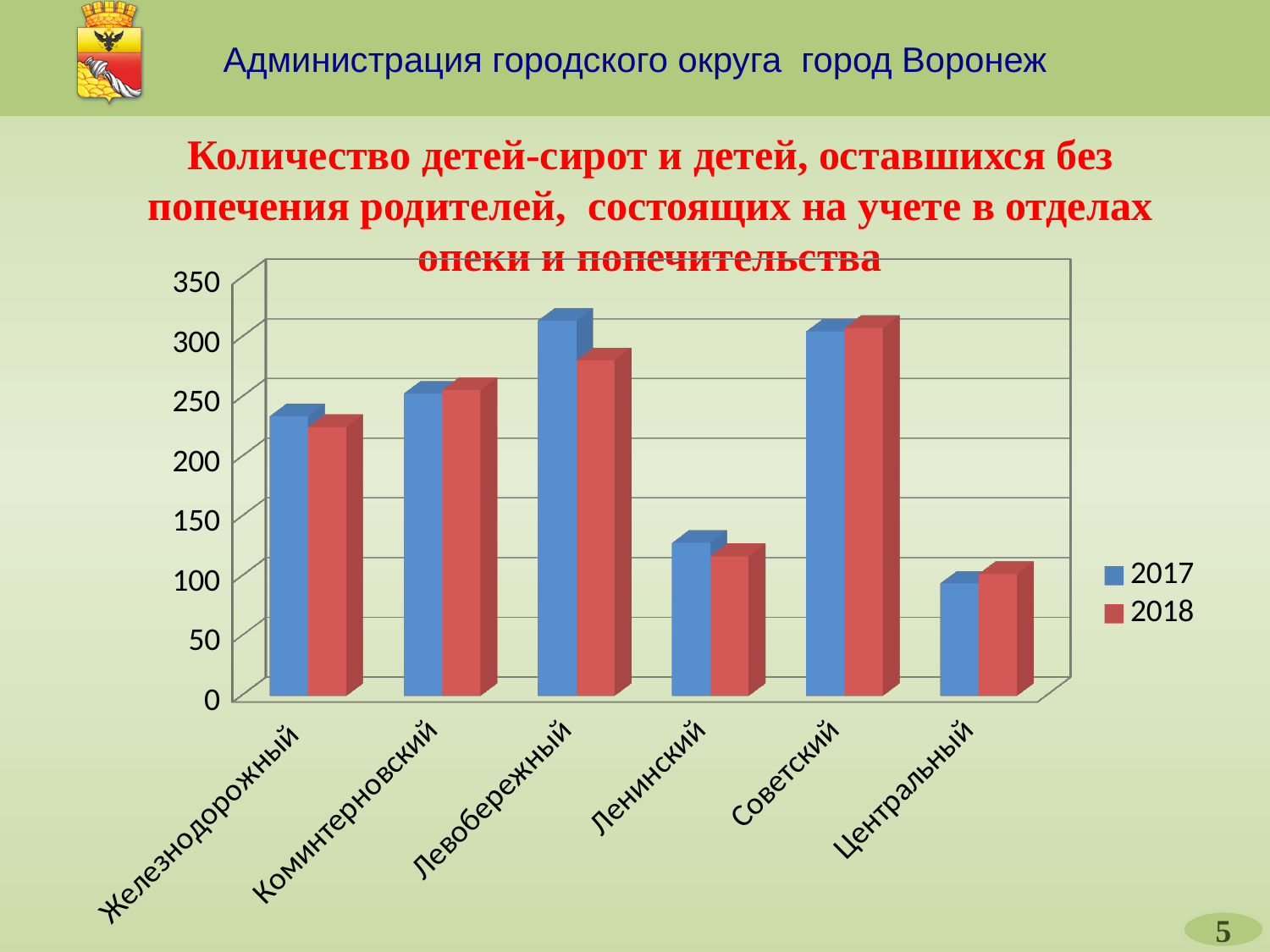
Which district has the highest value for 2018? Советский How many districts (categories) are shown on the x axis? 6 Is the 2018 value for Железнодорожный greater or less than 250? less Which colour represents the 2018 series in the legend? red For Левобережный, which year has the larger value, 2017 or 2018? 2017 Is the 2017 value for Ленинский greater or less than 150? less Which district has the highest value for 2017? Левобережный Is the 2017 value for Левобережный greater or less than 300? greater What kind of chart is shown on the slide? bar chart For Ленинский, which year has the larger value, 2017 or 2018? 2017 Which district has the lowest value for 2017? Центральный How many series does the legend list? 2